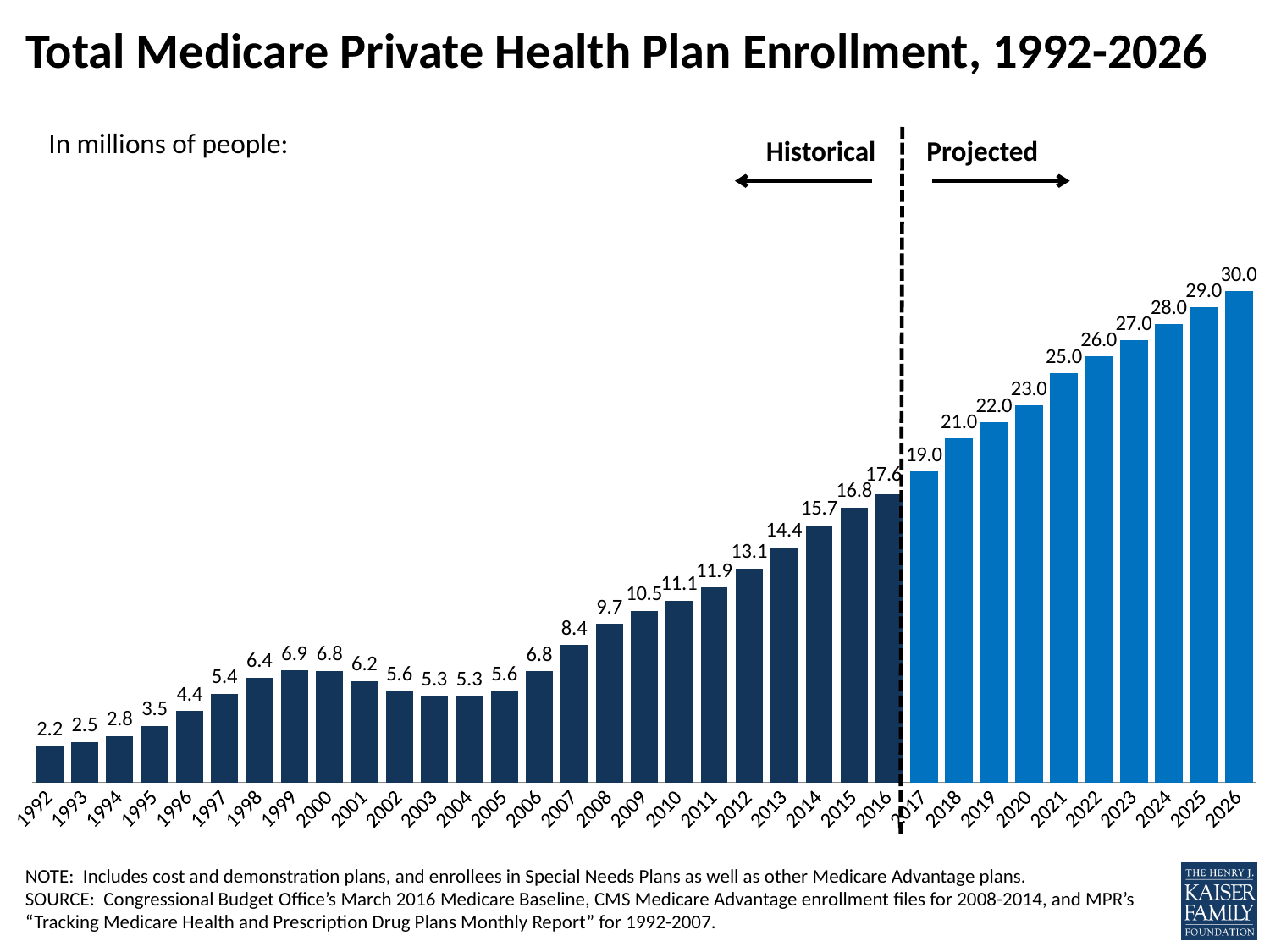
What is the enrollment value shown for 1999? 6.9 Which year has the highest enrollment value on the chart? 2026 What is the projected enrollment value for 2021? 25.0 What is the enrollment value shown for 2016? 17.6 What kind of chart is shown on the slide? Bar chart Which is larger, the value for 1998 or the value for 2001? 1998 What is the difference between the 2017 value and the 2016 value? 1.4 What are the two labeled sections of the chart separated by the dashed line? Historical and Projected What is the difference between the 2026 value and the 2016 value? 12.4 Which is larger, the value for 2000 or the value for 2006? 2000 and 2006 are equal (6.8) Which year has the lowest enrollment value on the chart? 1992 How many years (bars) are shown on the chart? 35